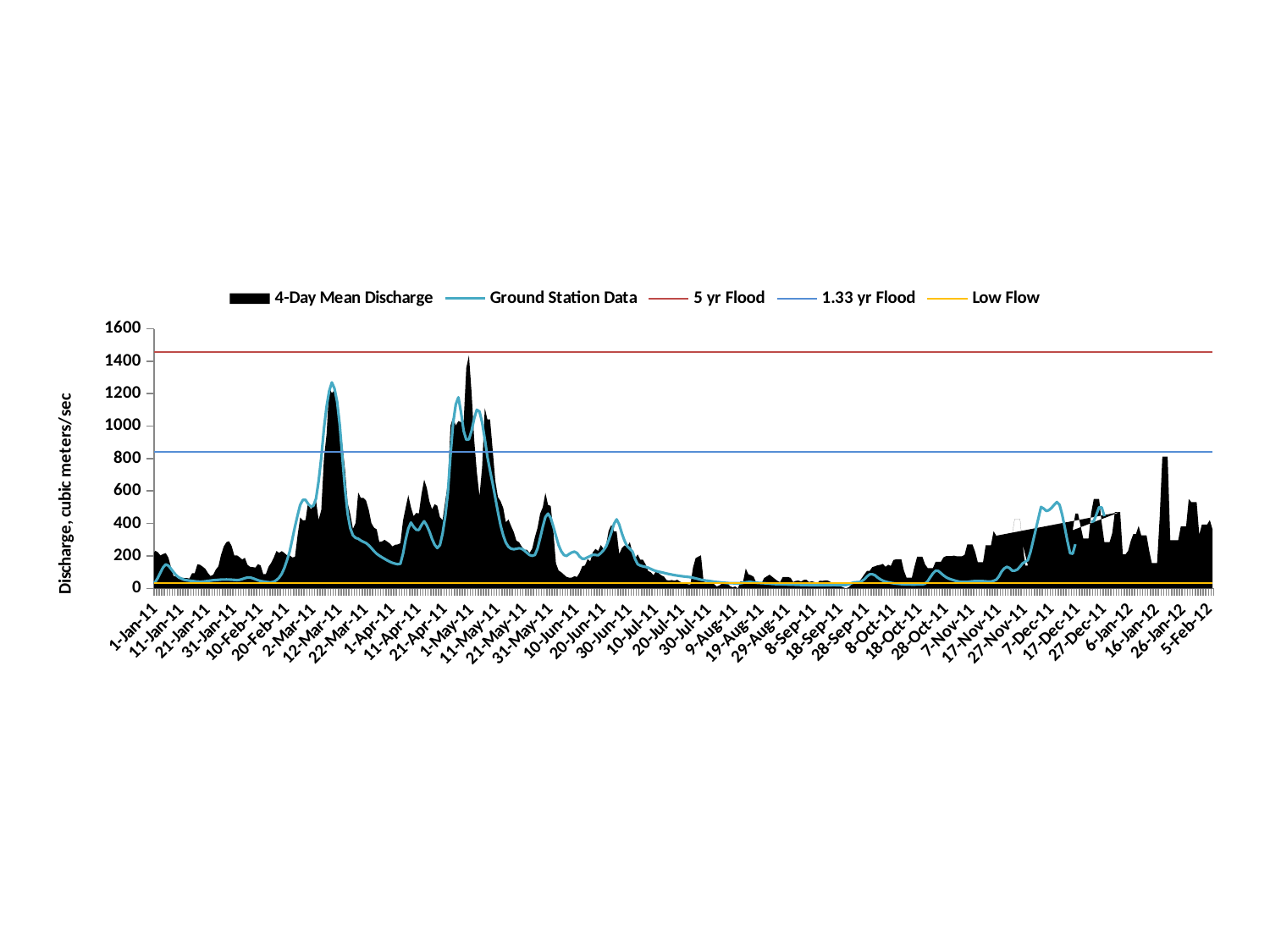
What kind of chart is shown on the slide? area and line chart Does the 4-Day Mean Discharge generally rise or fall between 1-May-11 and 9-Aug-11? fall How many series does the legend list? 5 Is the peak of the Ground Station Data around 12-Mar-11 greater or less than 1000? greater Is the Low Flow line greater or less than 200? less Is the 1.33 yr Flood line greater or less than 800? greater Which of the horizontal reference lines is the lowest: 5 yr Flood, 1.33 yr Flood or Low Flow? Low Flow What is the label of the vertical axis? Discharge, cubic meters/sec Which of the horizontal reference lines is the highest: 5 yr Flood, 1.33 yr Flood or Low Flow? 5 yr Flood Which series is drawn as a filled black area? 4-Day Mean Discharge